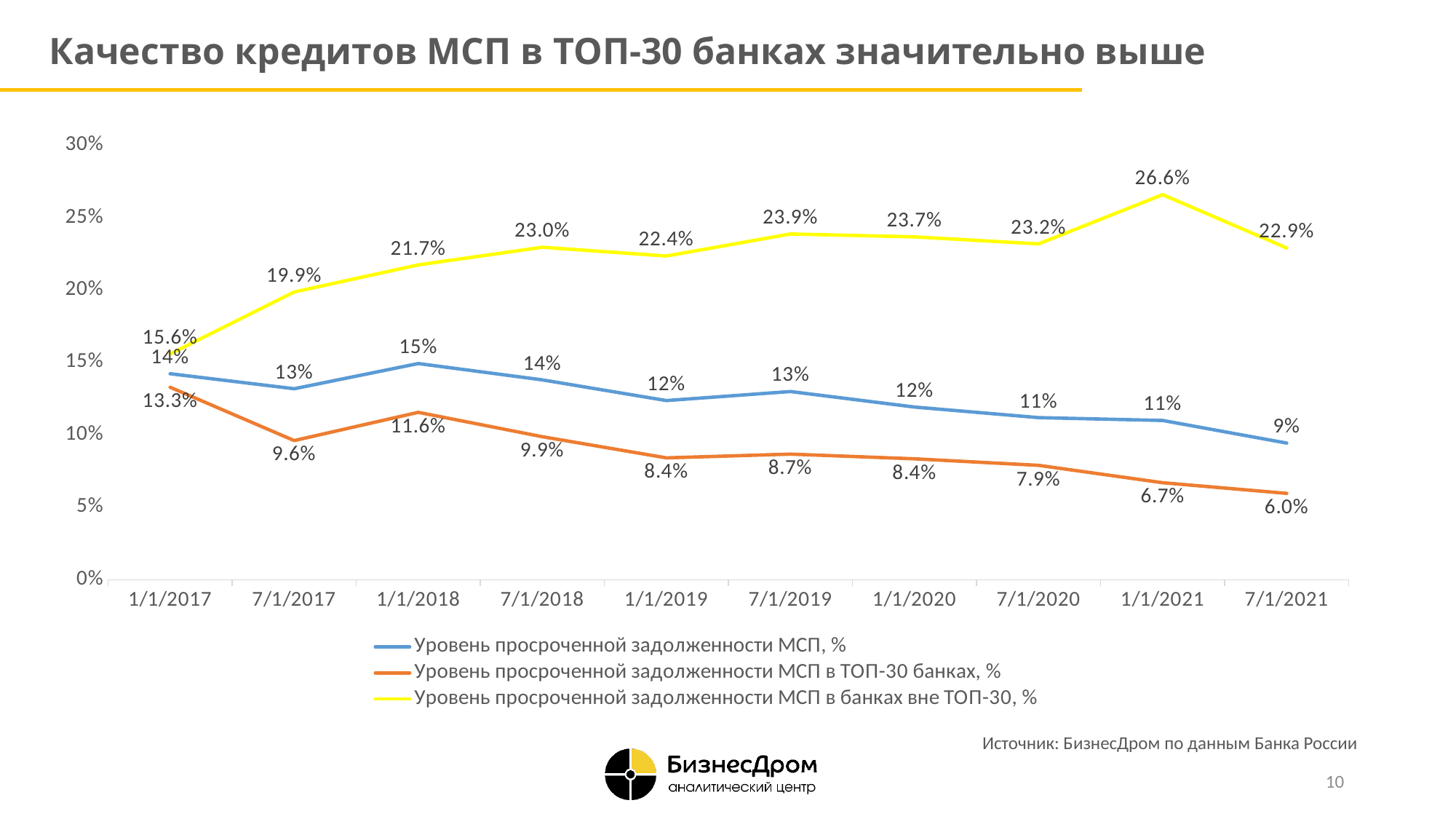
What colour is the line for 'Уровень просроченной задолженности МСП в банках вне ТОП-30, %'? yellow What is the value of 'Уровень просроченной задолженности МСП в ТОП-30 банках, %' on 7/1/2021? 6.0% How many series does the legend list? 3 What is the value of 'Уровень просроченной задолженности МСП в банках вне ТОП-30, %' on 1/1/2021? 26.6% What is the difference between 'Уровень просроченной задолженности МСП в банках вне ТОП-30, %' and 'Уровень просроченной задолженности МСП в ТОП-30 банках, %' on 7/1/2021? 16.9% Which series has the higher value on 1/1/2019: 'Уровень просроченной задолженности МСП, %' or 'Уровень просроченной задолженности МСП в ТОП-30 банках, %'? Уровень просроченной задолженности МСП, % What is the value of 'Уровень просроченной задолженности МСП, %' on 1/1/2018? 15% How many dates are shown on the x axis? 10 Does 'Уровень просроченной задолженности МСП в ТОП-30 банках, %' generally rise or fall from 1/1/2017 to 7/1/2021? fall On which date does 'Уровень просроченной задолженности МСП в банках вне ТОП-30, %' reach its highest value? 1/1/2021 On which date is 'Уровень просроченной задолженности МСП в ТОП-30 банках, %' at its lowest? 7/1/2021 What type of chart is shown on the slide? line chart